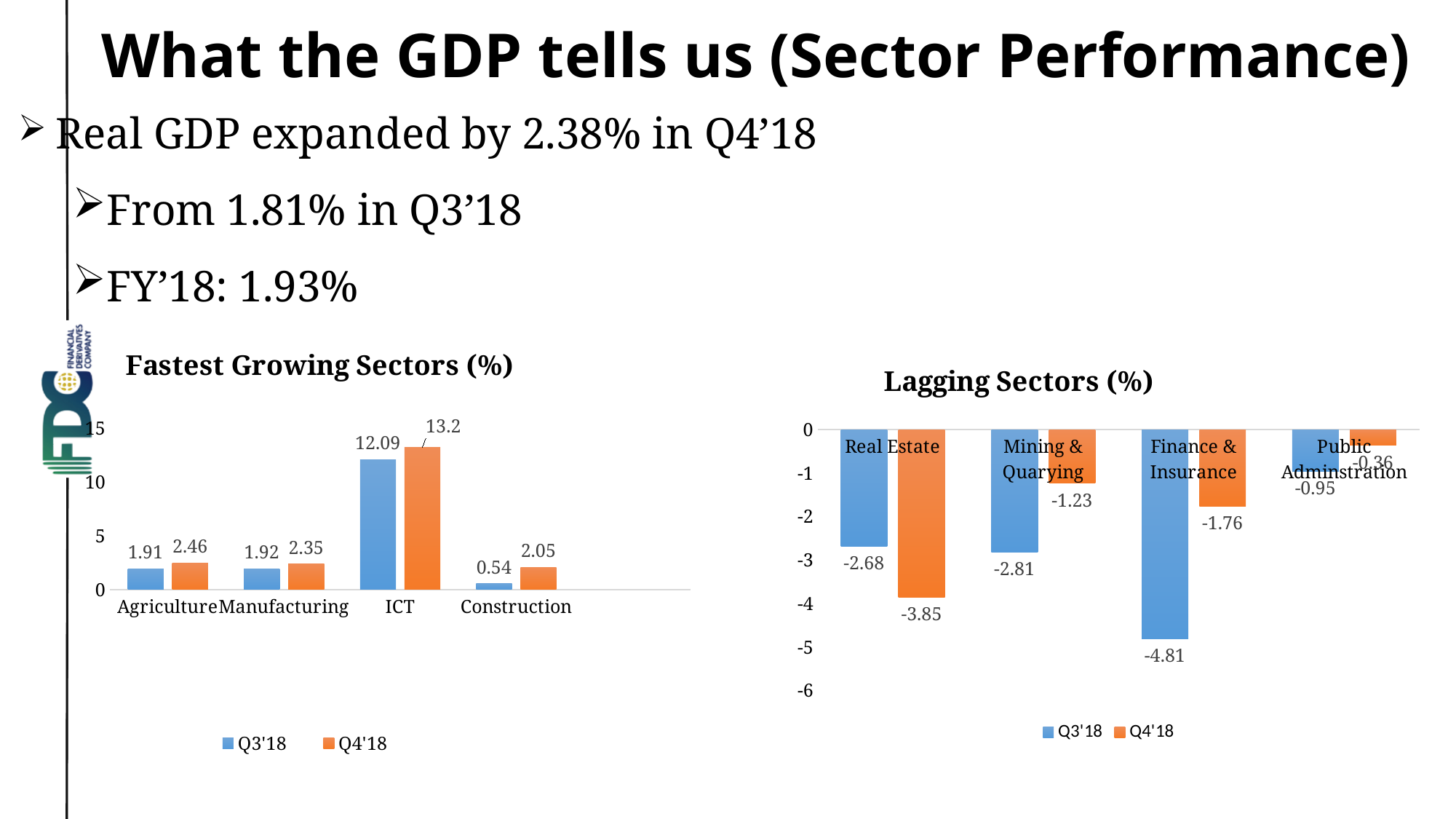
In the Fastest Growing Sectors (%) chart, which sector has the highest Q3'18 value? ICT In the Fastest Growing Sectors (%) chart, how many sectors are shown on the x axis? 4 In the Lagging Sectors (%) chart, which is larger, the Q4'18 value for Mining & Quarying or the Q4'18 value for Real Estate? Mining & Quarying In the Fastest Growing Sectors (%) chart, what is the Q3'18 value for Construction? 0.54 In the Fastest Growing Sectors (%) chart, what is the Q4'18 value for ICT? 13.2 How many series does the legend of the Lagging Sectors (%) chart list? 2 In the Lagging Sectors (%) chart, which sector has the lowest Q3'18 value? Finance & Insurance In the Lagging Sectors (%) chart, what is the Q4'18 value for Real Estate? -3.85 What type of chart is the Lagging Sectors (%) chart? Bar chart In the Fastest Growing Sectors (%) chart, what is the difference between the Q4'18 and Q3'18 values for Construction? 1.51 In the Fastest Growing Sectors (%) chart, is the Q3'18 value for ICT greater or less than 10? greater In the Lagging Sectors (%) chart, what is the Q3'18 value for Finance & Insurance? -4.81